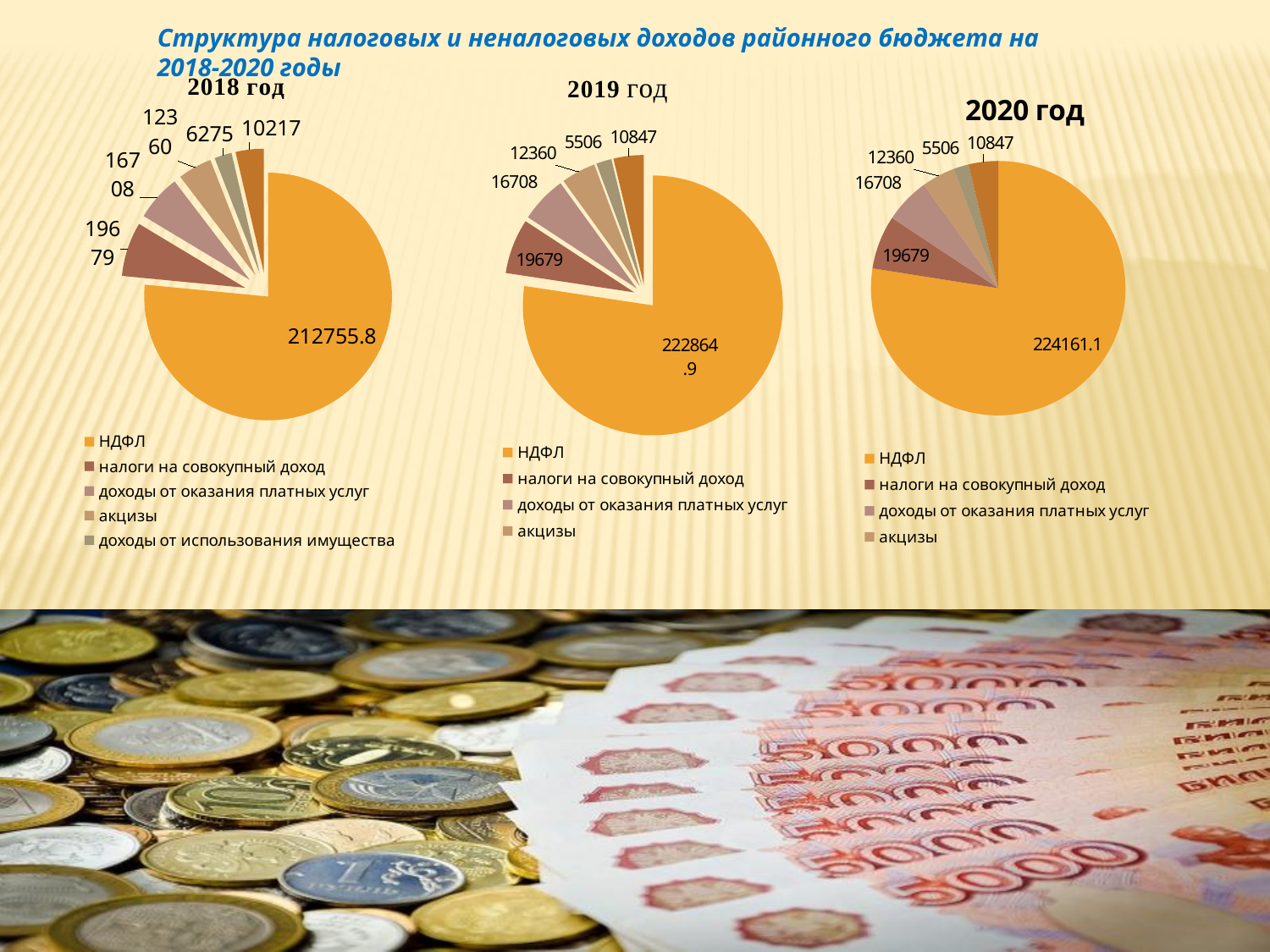
In the 2019 год chart, what is the value of the НДФЛ slice? 222864.9 Which is larger: the НДФЛ value in the 2019 год chart or in the 2020 год chart? 2020 год How many entries does the legend of the 2020 год chart list? 4 In the 2019 год chart, what is the value for доходы от оказания платных услуг? 16708 In the 2020 год chart, which category has the largest slice? НДФЛ In the 2018 год chart, what is the value of the НДФЛ slice? 212755.8 What is the difference between the НДФЛ value in the 2019 год chart and the 2018 год chart? 10109.1 What kind of charts are shown on the slide? Pie charts In the 2019 год chart, what is the value for налоги на совокупный доход? 19679 In the 2020 год chart, what is the value of the НДФЛ slice? 224161.1 How many entries does the legend of the 2018 год chart list? 5 What is the difference between the НДФЛ value in the 2020 год chart and the 2019 год chart? 1296.2